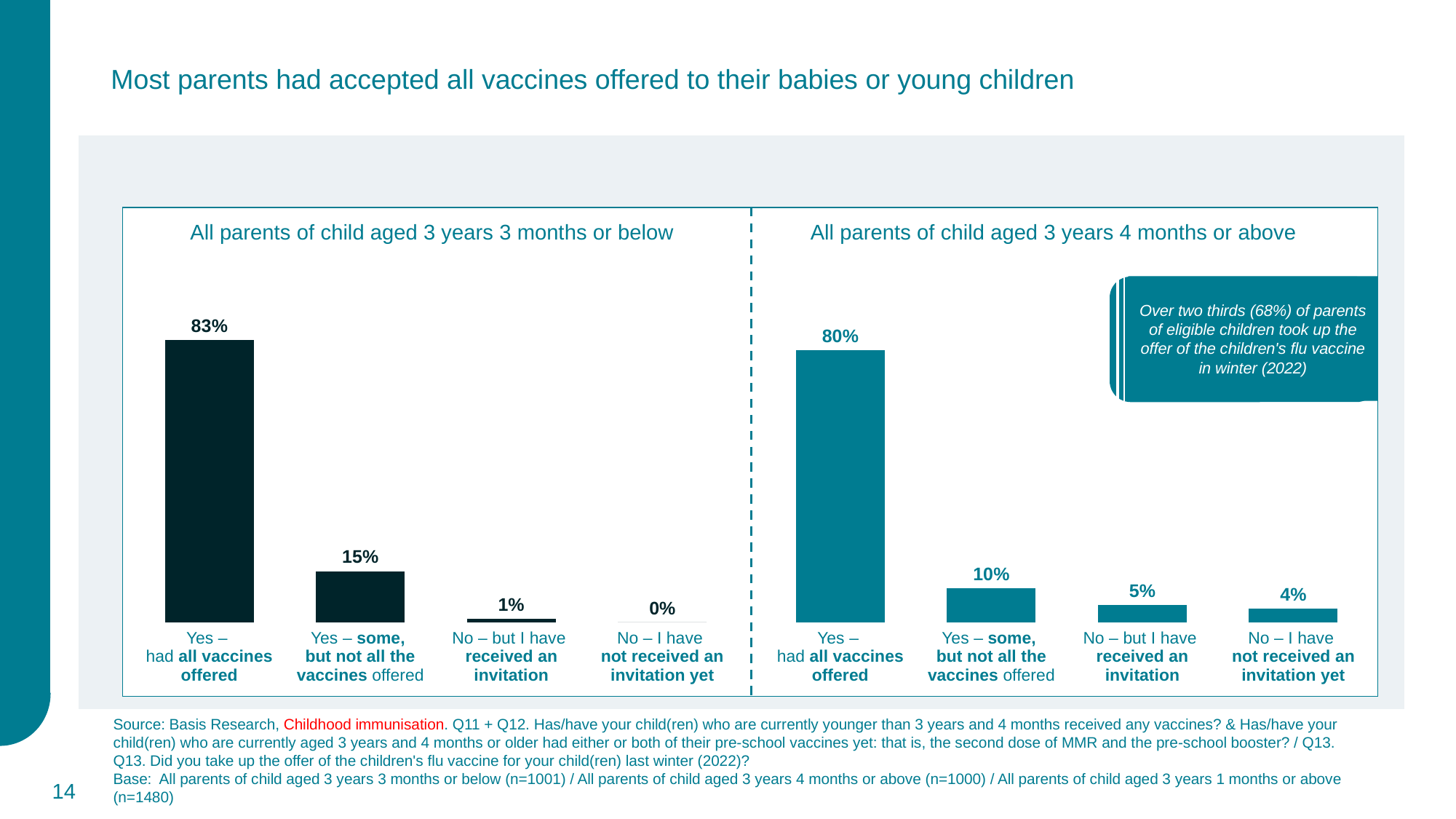
In the chart 'All parents of child aged 3 years 3 months or below', what percentage said 'Yes – some, but not all the vaccines offered'? 15% Which is larger: 'No – but I have received an invitation' in the left chart (3 years 3 months or below) or in the right chart (3 years 4 months or above)? Right chart (3 years 4 months or above) In the chart 'All parents of child aged 3 years 4 months or above', what percentage had all vaccines offered? 80% In the chart 'All parents of child aged 3 years 3 months or below', what percentage had all vaccines offered? 83% In the chart 'All parents of child aged 3 years 3 months or below', which category has the lowest value? No – I have not received an invitation yet How many categories are shown in the chart 'All parents of child aged 3 years 3 months or below'? 4 In the chart 'All parents of child aged 3 years 4 months or above', which category has the highest value? Yes – had all vaccines offered In the chart 'All parents of child aged 3 years 4 months or above', what is the difference between 'Yes – some, but not all the vaccines offered' and 'No – but I have received an invitation'? 5 percentage points In the chart 'All parents of child aged 3 years 4 months or above', what percentage said 'No – I have not received an invitation yet'? 4% What is the difference between the 'Yes – had all vaccines offered' values in the left chart (3 years 3 months or below) and the right chart (3 years 4 months or above)? 3 percentage points According to the callout box on the right chart, what percentage of parents of eligible children took up the offer of the children's flu vaccine in winter 2022? 68% What type of chart is used on this slide? Bar chart